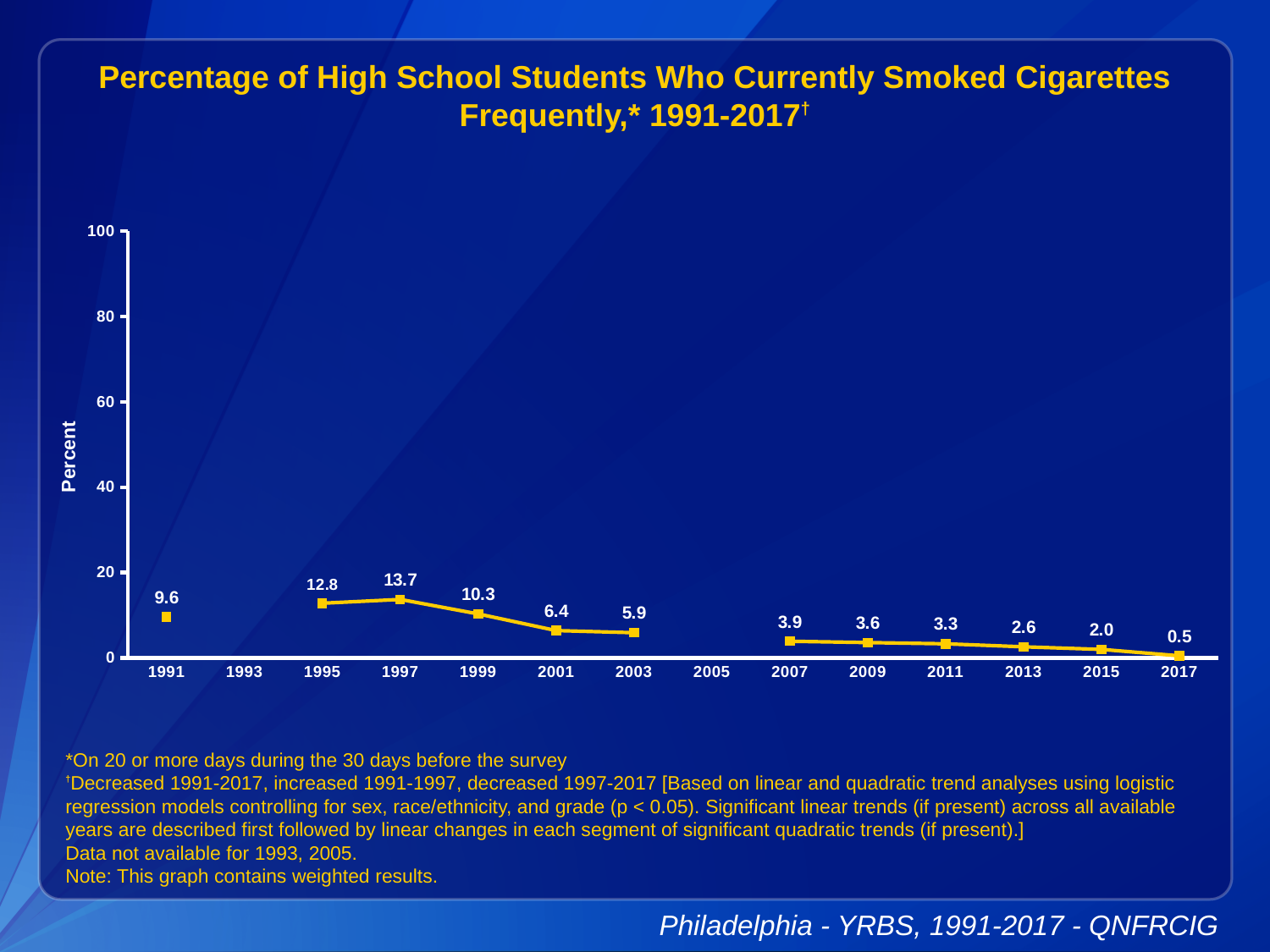
What is the value plotted for 2003? 5.9 What is the difference between the values for 1997 and 2017? 13.2 Which year has the highest value on the chart? 1997 Do the values rise or fall from 1997 to 2017? fall What percentage of high school students currently smoked cigarettes frequently in 1991? 9.6 How many data points are plotted on the chart? 12 What is the difference between the values for 1995 and 1999? 2.5 Is the value for 1997 greater or less than 20? less Which year has the lowest value on the chart? 2017 What kind of chart is shown on the slide? line chart Which year has a larger value, 2001 or 2009? 2001 What is the value plotted for 2017? 0.5